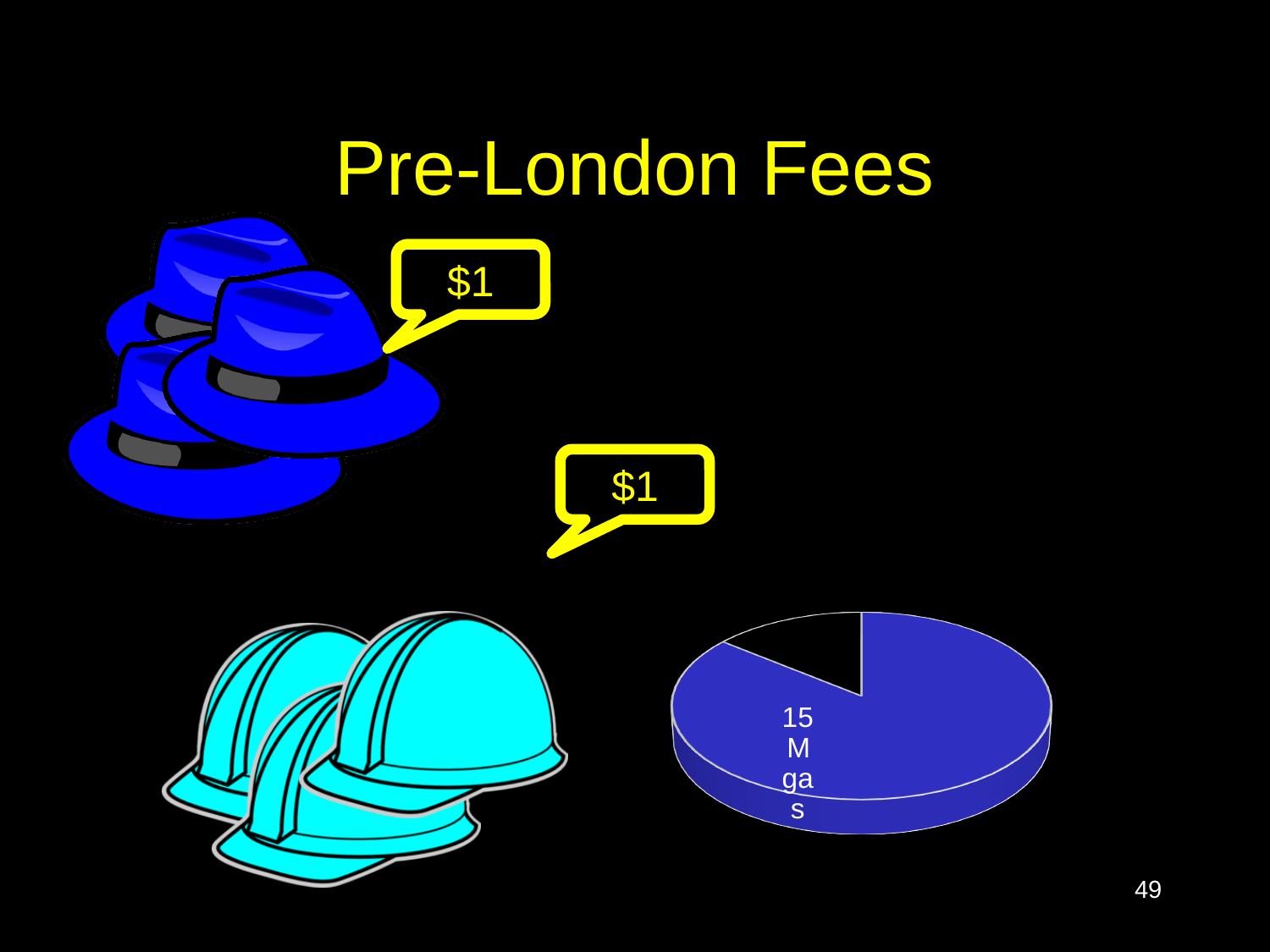
In the pie chart, which slice is larger, the blue slice or the black slice? the blue slice What label is printed on the large blue slice of the pie chart? 15 M gas What kind of chart is shown at the bottom right of the slide? pie chart What is the title of the slide containing the pie chart? Pre-London Fees How many slices does the pie chart show? 2 What colour is the slice labelled "15 M gas" in the pie chart? blue